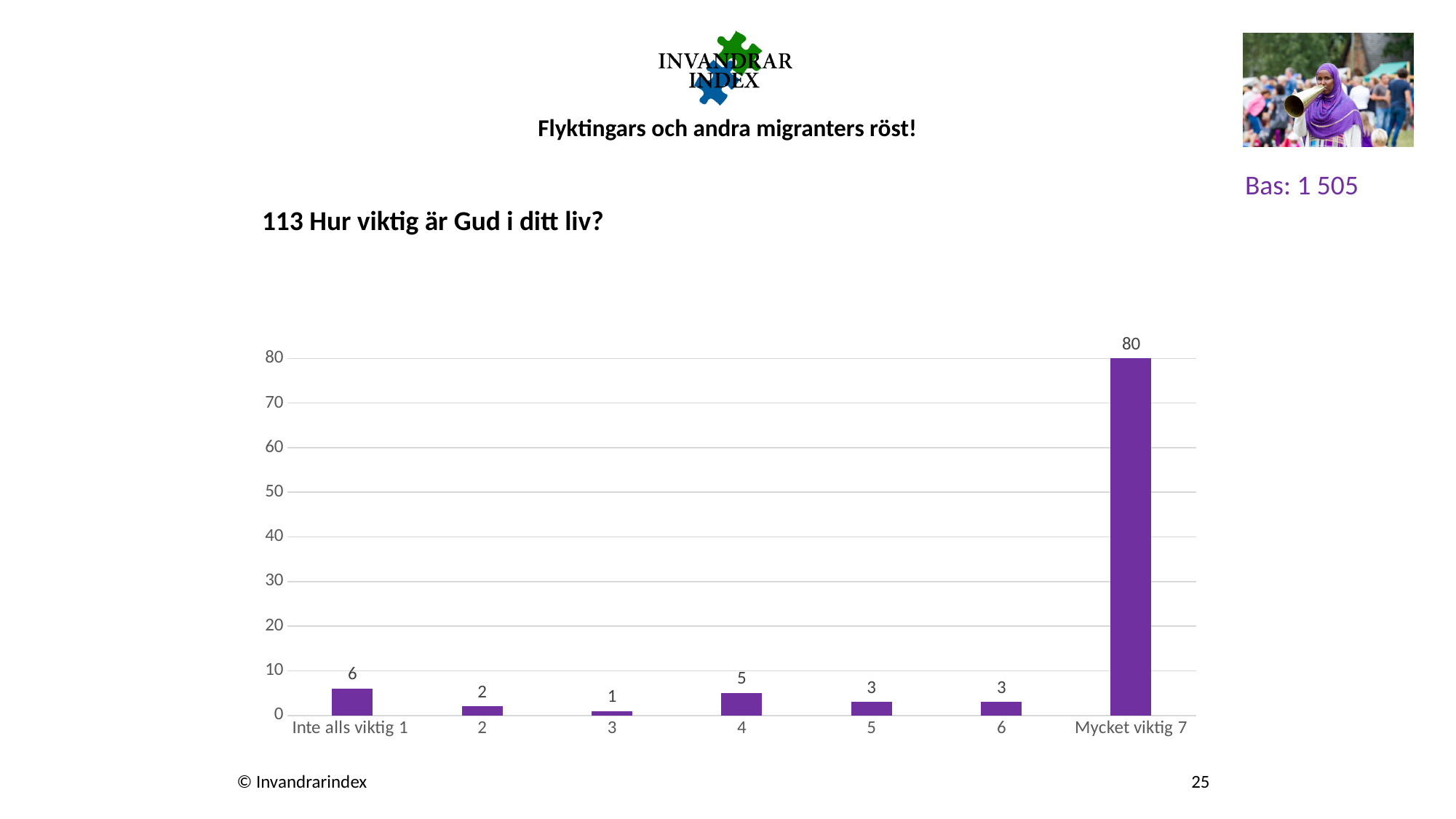
What is the value for category 3? 1 Which is larger, the value for category 2 or the value for category 4? 4 Is the value for "Mycket viktig 7" greater or less than 70? greater What is the value for category 4? 5 What is the difference between the values for "Mycket viktig 7" and "Inte alls viktig 1"? 74 Which category has the highest value? Mycket viktig 7 What is the value for "Inte alls viktig 1"? 6 How many categories are shown on the x axis? 7 Which category has the lowest value? 3 What is the value for "Mycket viktig 7"? 80 What is the base (Bas) shown on the slide? 1 505 What kind of chart is shown on the slide? bar chart